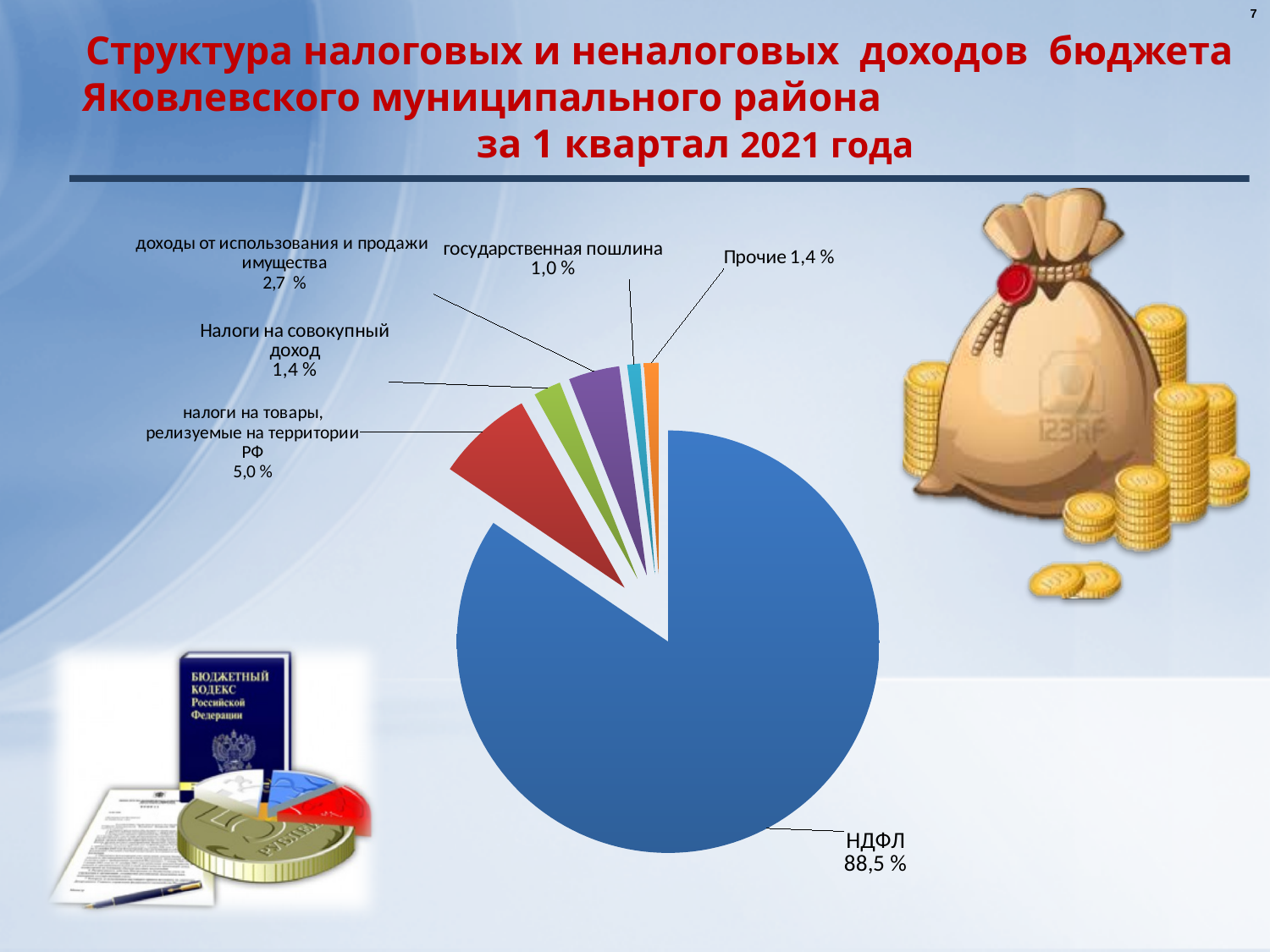
What kind of chart is shown on the slide? pie chart What is the value shown for государственная пошлина? 1,0 % What is the value shown for налоги на товары, релизуемые на территории РФ? 5,0 % What share of the pie does НДФЛ account for? 88,5 % How many slices does the pie chart have? 6 What is the difference between the share of НДФЛ and the share of налоги на товары, релизуемые на территории РФ? 83,5 % Which is larger: the share of налоги на товары, релизуемые на территории РФ or the share of доходы от использования и продажи имущества? налоги на товары, релизуемые на территории РФ Which category has the largest share of the pie? НДФЛ What is the value shown for Налоги на совокупный доход? 1,4 % What is the value shown for доходы от использования и продажи имущества? 2,7 % Which category has the smallest share of the pie? государственная пошлина What is the value shown for Прочие? 1,4 %